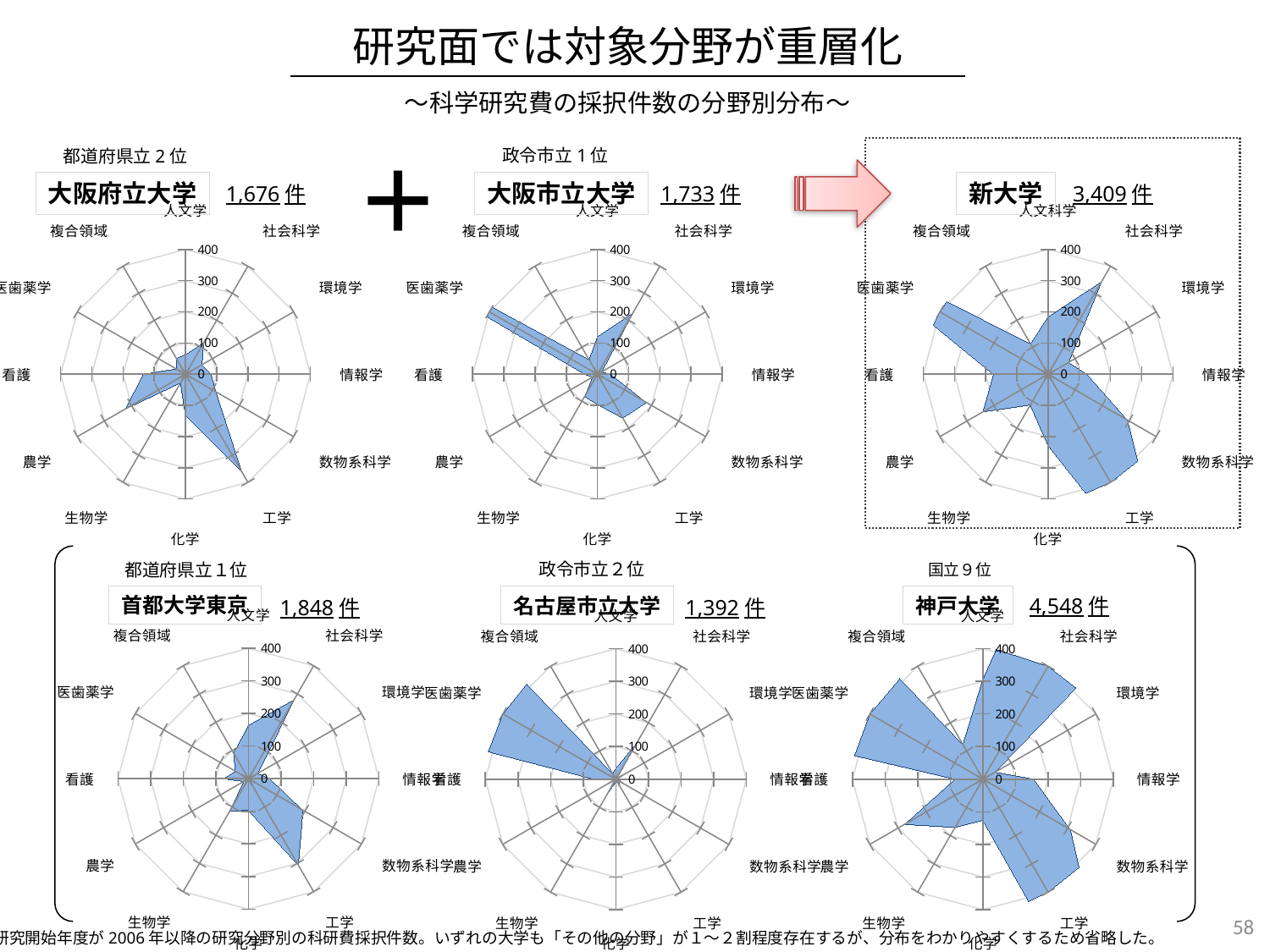
How many research field categories does the 新大学 radar chart have? 12 In the 新大学 chart, which field has the highest value? 工学 How many radar charts are shown on the slide? 6 In the 名古屋市立大学 chart, is the value for 工学 greater or less than 100? less What is the maximum value shown on the radial axis of the 神戸大学 chart? 400 In the 名古屋市立大学 chart, which field has the highest value? 医歯薬学 What kind of chart is used for 大阪府立大学? Radar chart In the 大阪府立大学 chart, which field has the highest value? 工学 In the 新大学 chart, is the value for 工学 greater or less than 300? greater In the 神戸大学 chart, is the value for 工学 greater or less than 300? greater